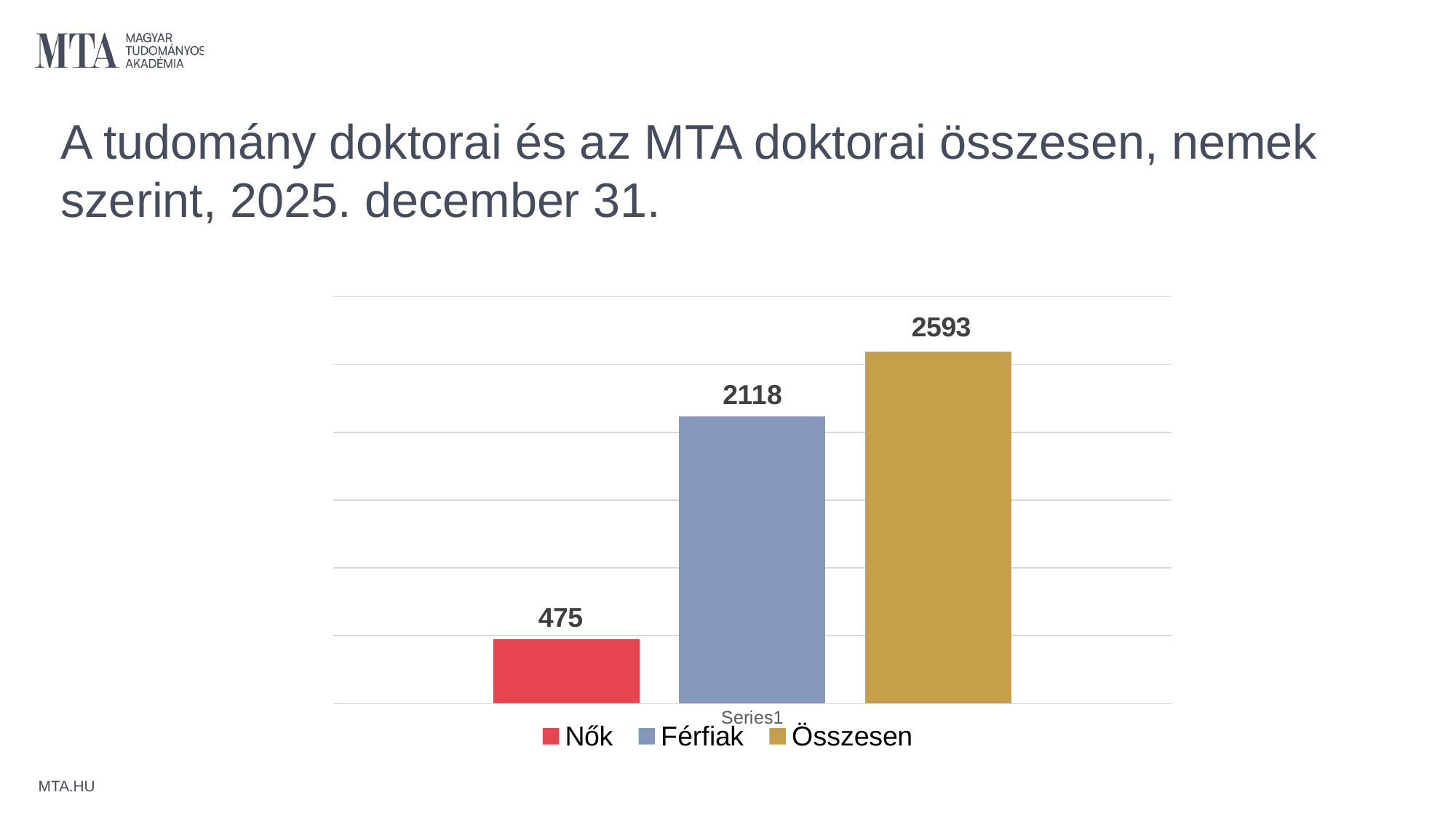
How many bars are plotted in the chart? 3 How many series does the legend list? 3 What kind of chart is shown on the slide? bar chart Which is larger, the value for Nők or the value for Férfiak? Férfiak What colour is the bar for Nők? red What is the value for Nők? 475 What is the difference between the values for Összesen and Férfiak? 475 What is the difference between the values for Férfiak and Nők? 1643 Which series has the highest value? Összesen What is the value for Férfiak? 2118 Which series has the lowest value? Nők What is the value for Összesen? 2593